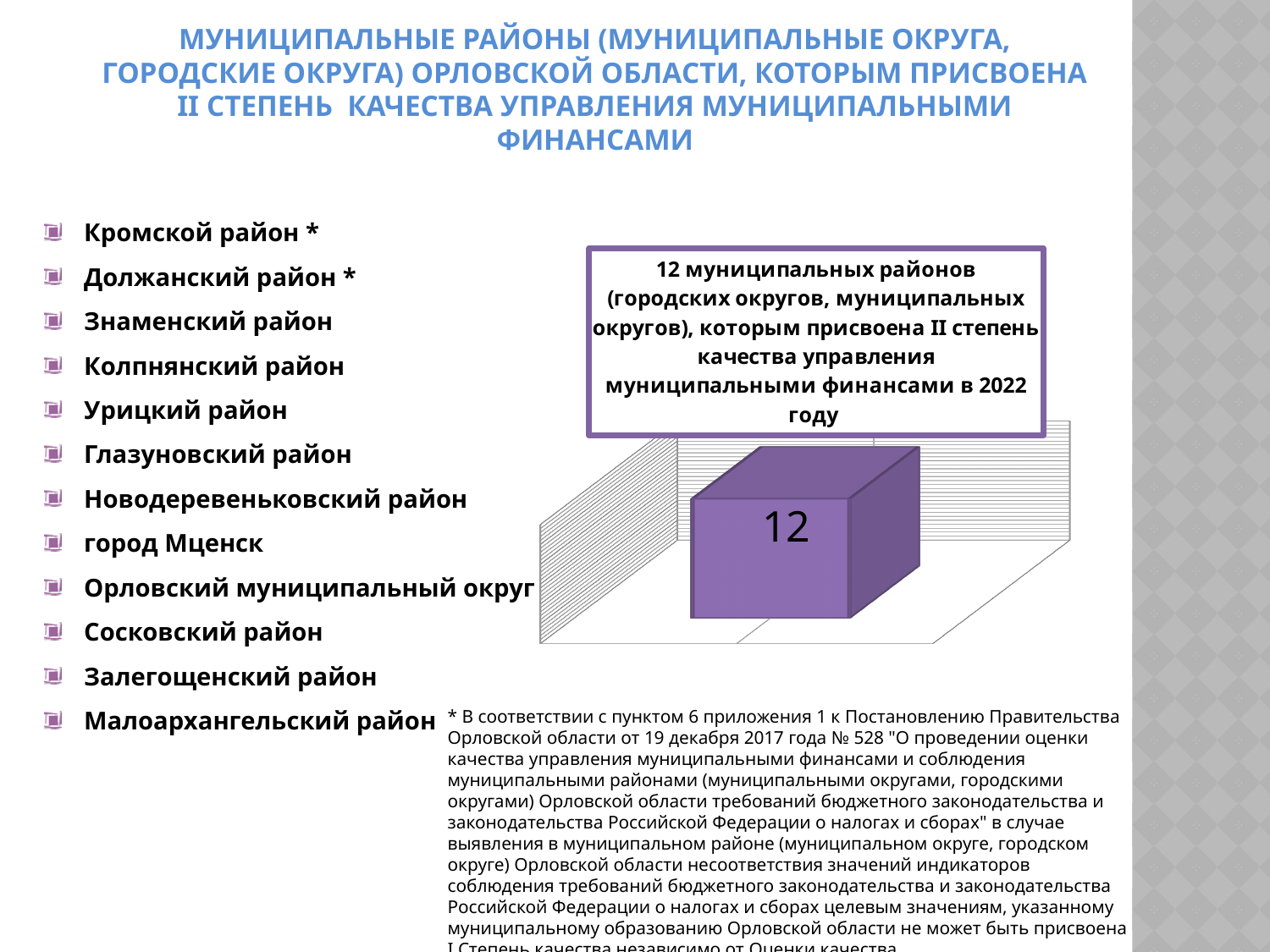
What colour is the bar in the chart? purple What value is printed on the bar in the chart? 12 What kind of chart is shown on the slide? bar chart Which year does the chart's title box refer to? 2022 According to the chart's title box, how many municipal districts (urban districts, municipal okrugs) were assigned the II degree of quality of municipal finance management in 2022? 12 How many bars are plotted in the chart? 1